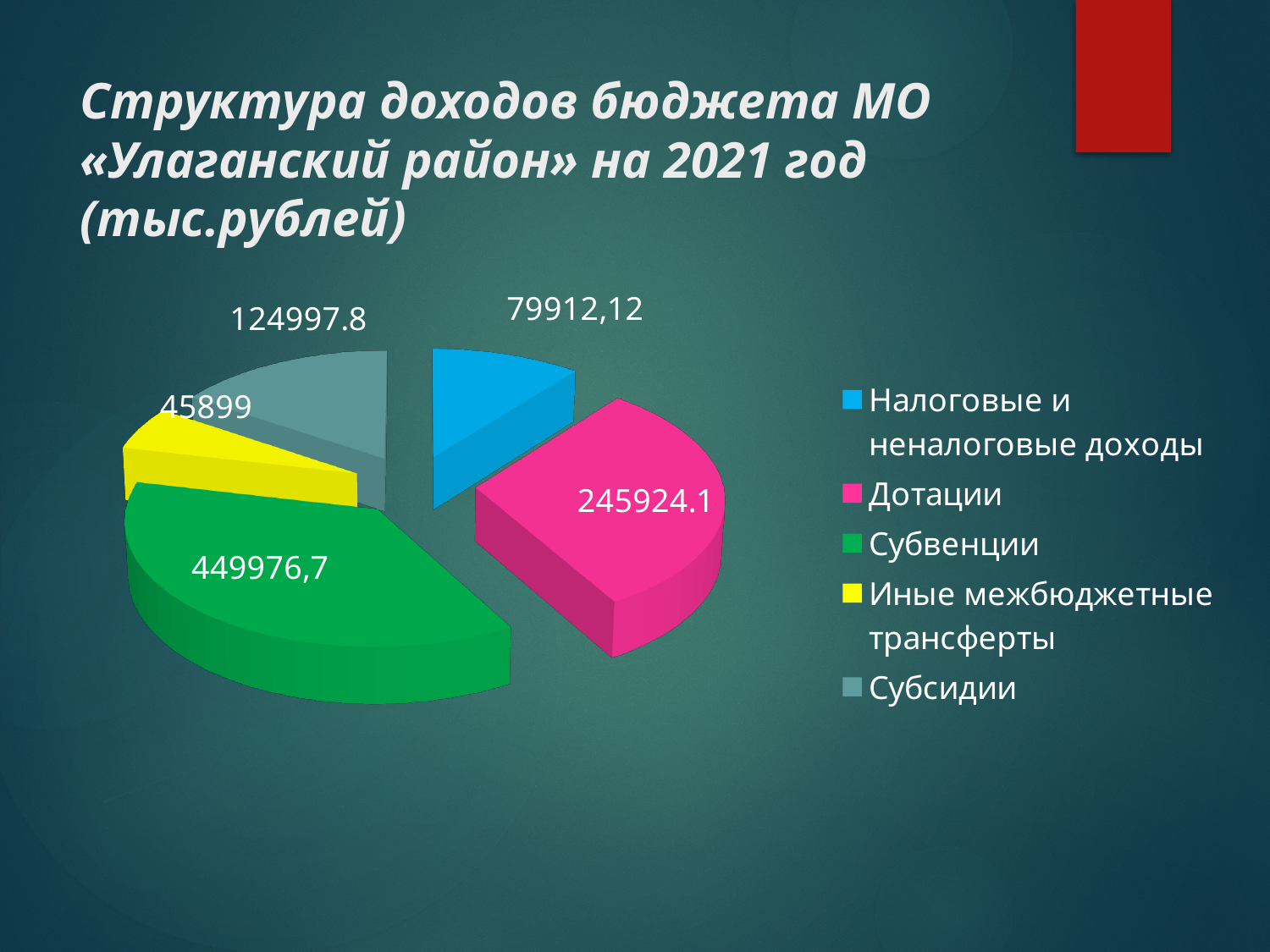
What is the value for Субвенции? 449976,7 Which category has the largest value? Субвенции What is the difference between the values for Дотации and Субсидии? 120926.3 Which category has the smallest value? Иные межбюджетные трансферты Which legend entry is shown in pink? Дотации What kind of chart is shown on the slide? Pie chart How many slices does the pie chart have? 5 Which is larger, Дотации or Субсидии? Дотации What is the value for Субсидии? 124997.8 What is the value for Дотации? 245924.1 What is the value for Иные межбюджетные трансферты? 45899 What is the value for Налоговые и неналоговые доходы? 79912,12